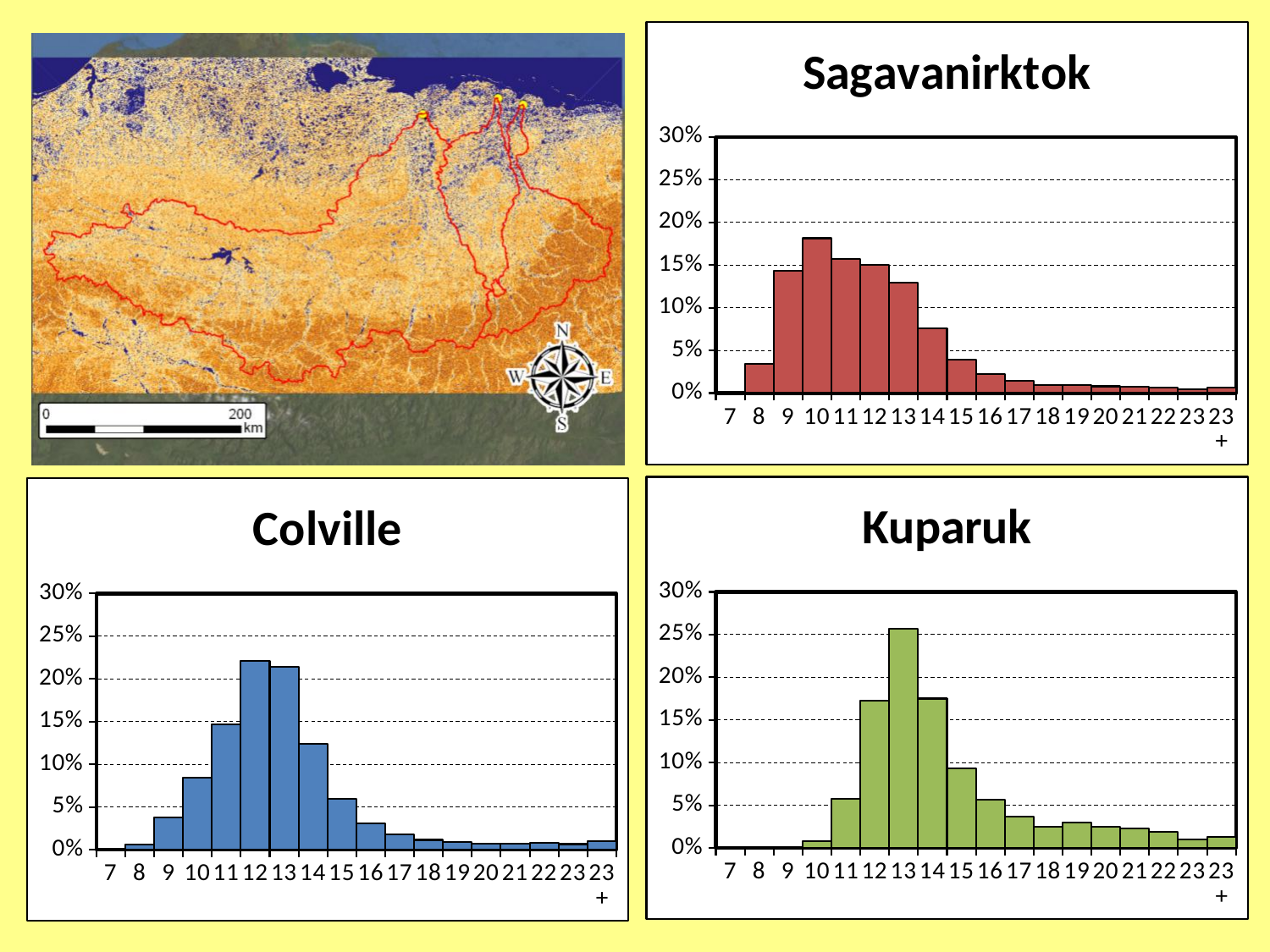
What colour are the bars in the Colville chart? blue In the Sagavanirktok chart, which category has the highest value? 10 In the Kuparuk chart, which category has the highest value? 13 In the Colville chart, is the value for 9 greater or less than 5%? less In the Colville chart, which is larger, the value for 10 or the value for 14? 14 In the Sagavanirktok chart, do the values rise or fall from category 10 to category 23+? fall In the Sagavanirktok chart, is the value for 10 greater or less than 15%? greater What kind of chart is the Sagavanirktok chart? bar chart In the Sagavanirktok chart, is the value for 14 greater or less than 5%? greater How many categories are shown on the x axis of the Kuparuk chart? 18